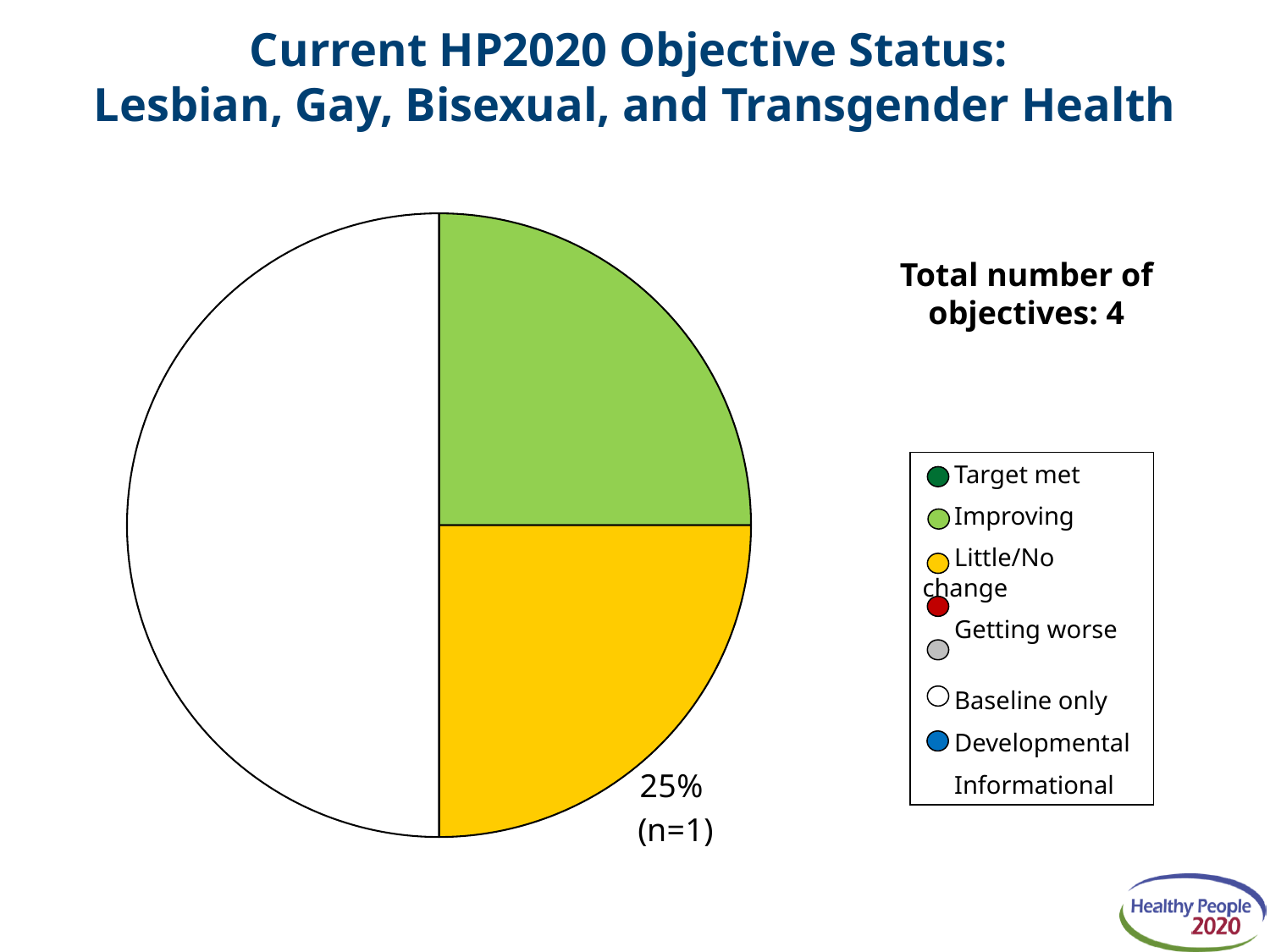
What percentage is printed as the data label on the pie chart? 25% What share of the pie does the Little/No change slice represent, according to the printed label? 25% What is the n value printed next to the 25% label on the pie chart? n=1 What kind of chart is shown on the slide? pie chart What colour represents the Improving category in the pie chart? green How many status categories does the legend list? 7 What is the total number of objectives stated on the slide? 4 How many slices are visible in the pie chart? 3